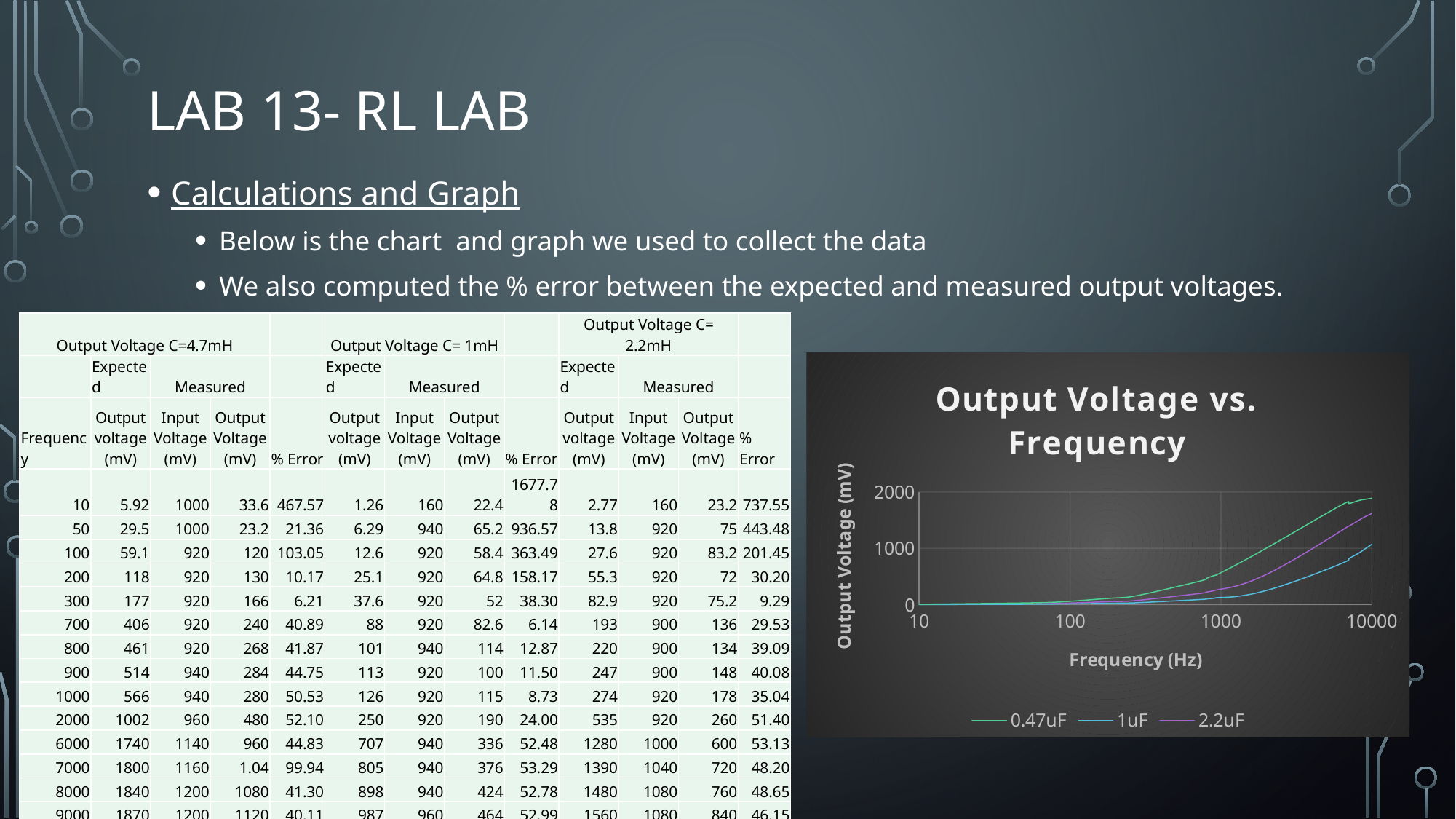
Do the output voltage values rise or fall as frequency increases along the x axis? rise What is the maximum value shown on the chart's y axis? 2000 Is the value for 2.2uF at 100 Hz greater or less than 1000? less How many series does the chart's legend list? 3 What kind of chart is shown on the slide? line chart Is the value for 0.47uF at 10000 Hz greater or less than 1000? greater Which series has the lowest output voltage at the right end of the chart (10000 Hz)? 1uF Which series has the highest output voltage at the right end of the chart (10000 Hz)? 0.47uF What are the series names listed in the chart's legend? 0.47uF, 1uF, 2.2uF What is the title of the chart on the slide? Output Voltage vs. Frequency At 10000 Hz, which series has the larger output voltage, 0.47uF or 2.2uF? 0.47uF